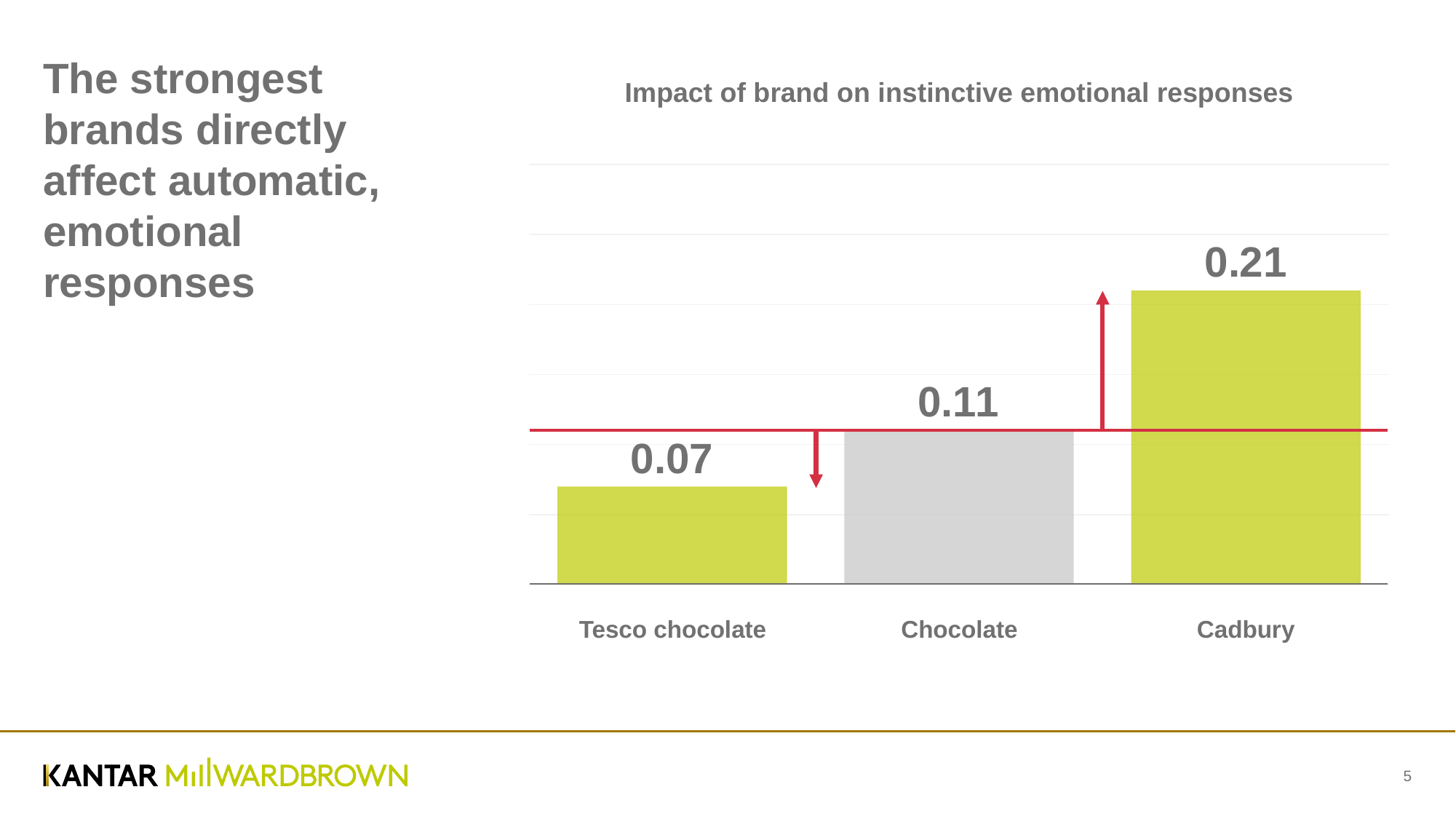
Which category's bar is coloured grey rather than green? Chocolate What is the difference between the values for Cadbury and Tesco chocolate? 0.14 Which category has the highest value? Cadbury What is the difference between the values for Chocolate and Tesco chocolate? 0.04 What is the value for Cadbury? 0.21 What kind of chart is shown on the slide? Bar chart How many categories are shown on the chart? 3 Which is larger, the value for Cadbury or the value for Chocolate? Cadbury What is the value for Chocolate? 0.11 What is the value for Tesco chocolate? 0.07 What is the title of the chart? Impact of brand on instinctive emotional responses Which category has the lowest value? Tesco chocolate